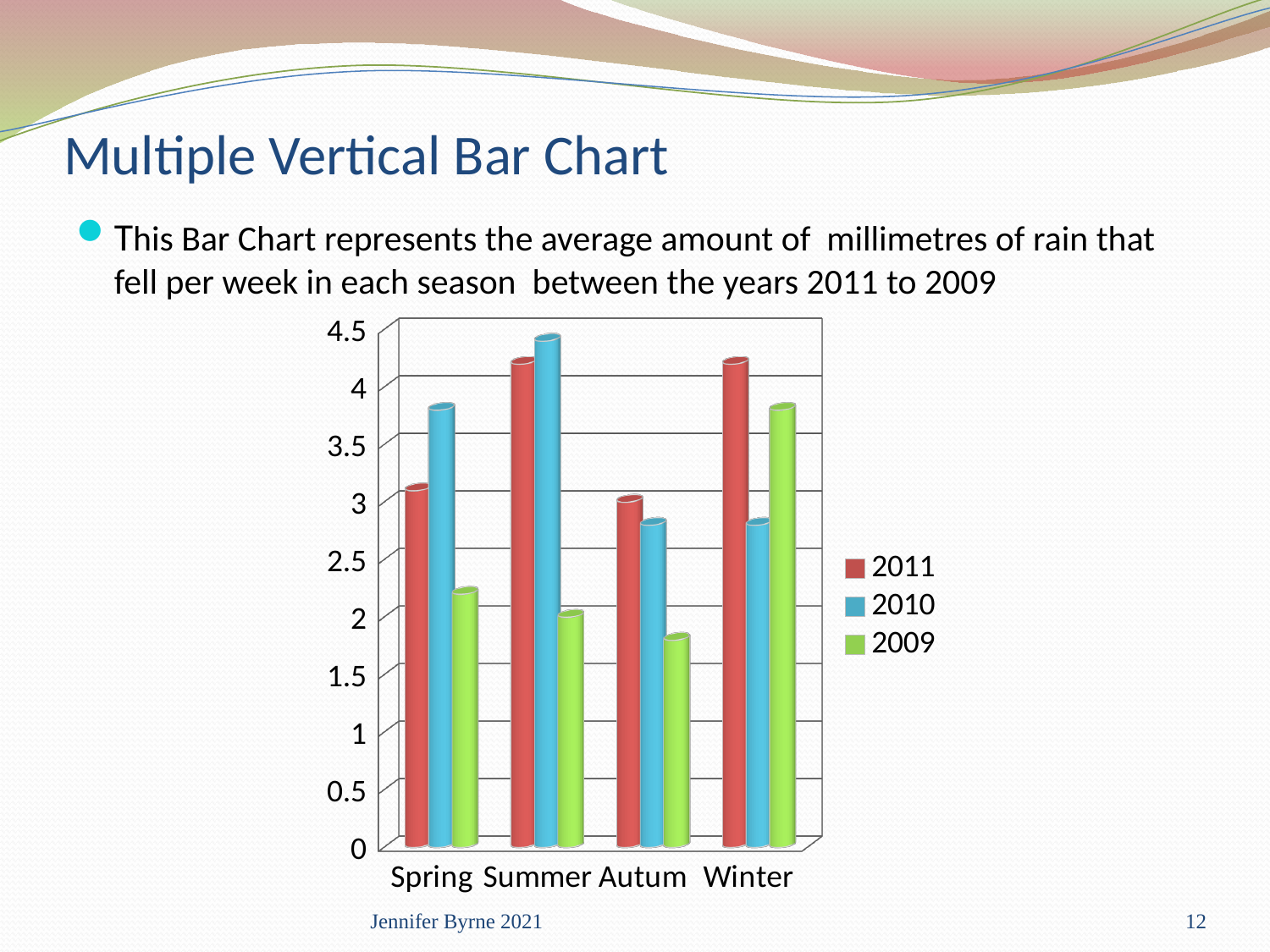
Is the value for 2009 in Spring greater or less than 2.5? less What colour represents the 2009 series in the chart? green Is the value for 2010 in Summer greater or less than 4? greater How many series does the chart's legend list? 3 How many seasons are shown on the x axis of the chart? 4 In which season is the 2010 value highest? Summer In Winter, which is larger: the value for 2011 or the value for 2010? 2011 In which season is the 2009 value highest? Winter What kind of chart is shown on the slide? bar chart Is the value for 2011 in Winter greater or less than 4? greater Which years are listed in the chart's legend? 2011, 2010, 2009